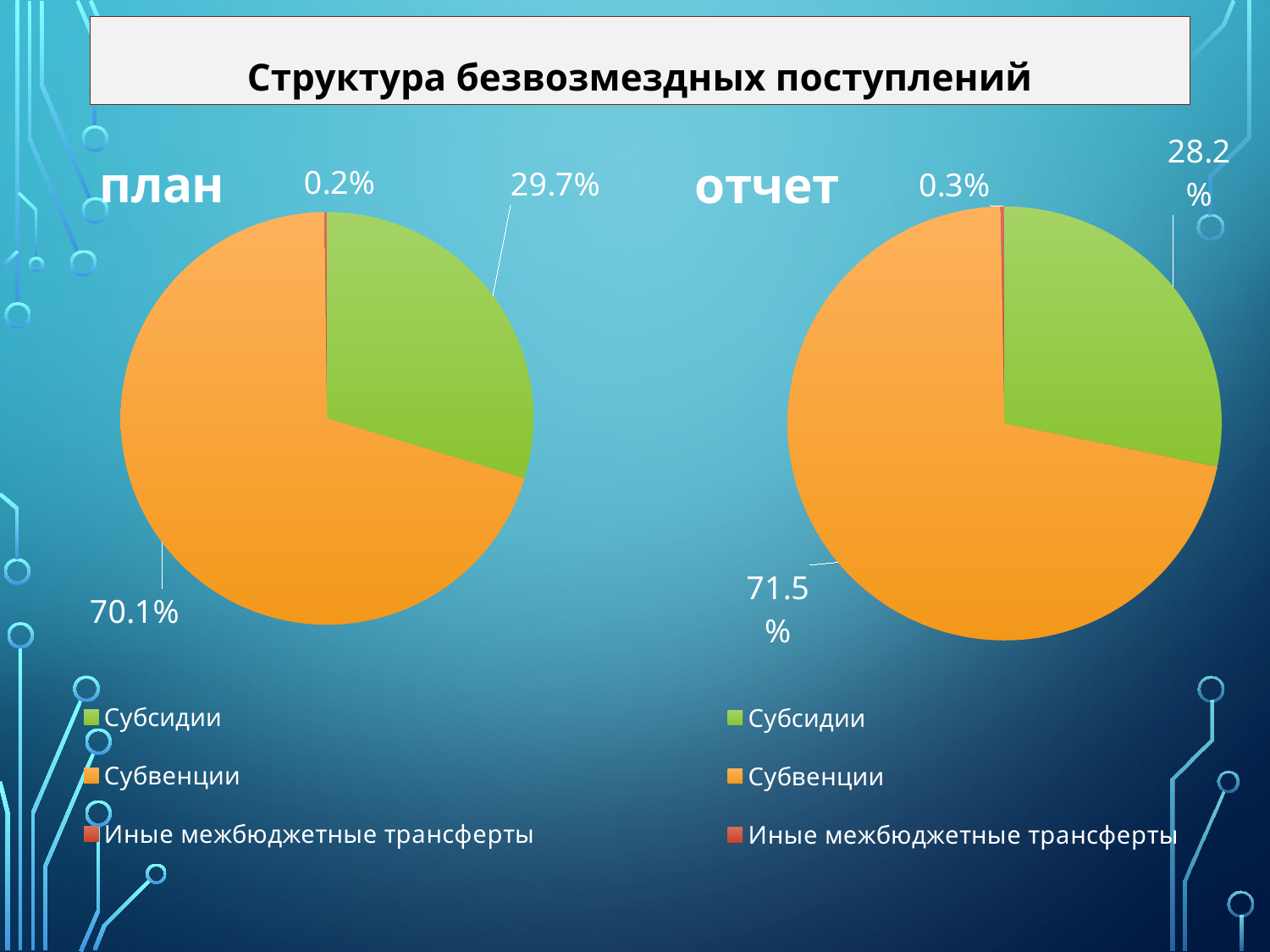
In the "отчет" chart, what share does Субсидии have? 28.2% What is the difference between the Субвенции share in the "отчет" chart and the Субвенции share in the "план" chart? 1.4% In the "план" chart, what share does Субвенции have? 70.1% In the "отчет" chart, what share does Иные межбюджетные трансферты have? 0.3% In the "отчет" chart, which category has the largest slice? Субвенции In the "план" chart, what share does Субсидии have? 29.7% In the "план" chart, which category has the smallest slice? Иные межбюджетные трансферты How many categories does the legend of the "план" chart list? 3 What kind of chart is the "план" chart? pie chart In the "отчет" chart, what share does Субвенции have? 71.5% What is the title of the slide above the two charts? Структура безвозмездных поступлений In the "план" chart, what share does Иные межбюджетные трансферты have? 0.2%